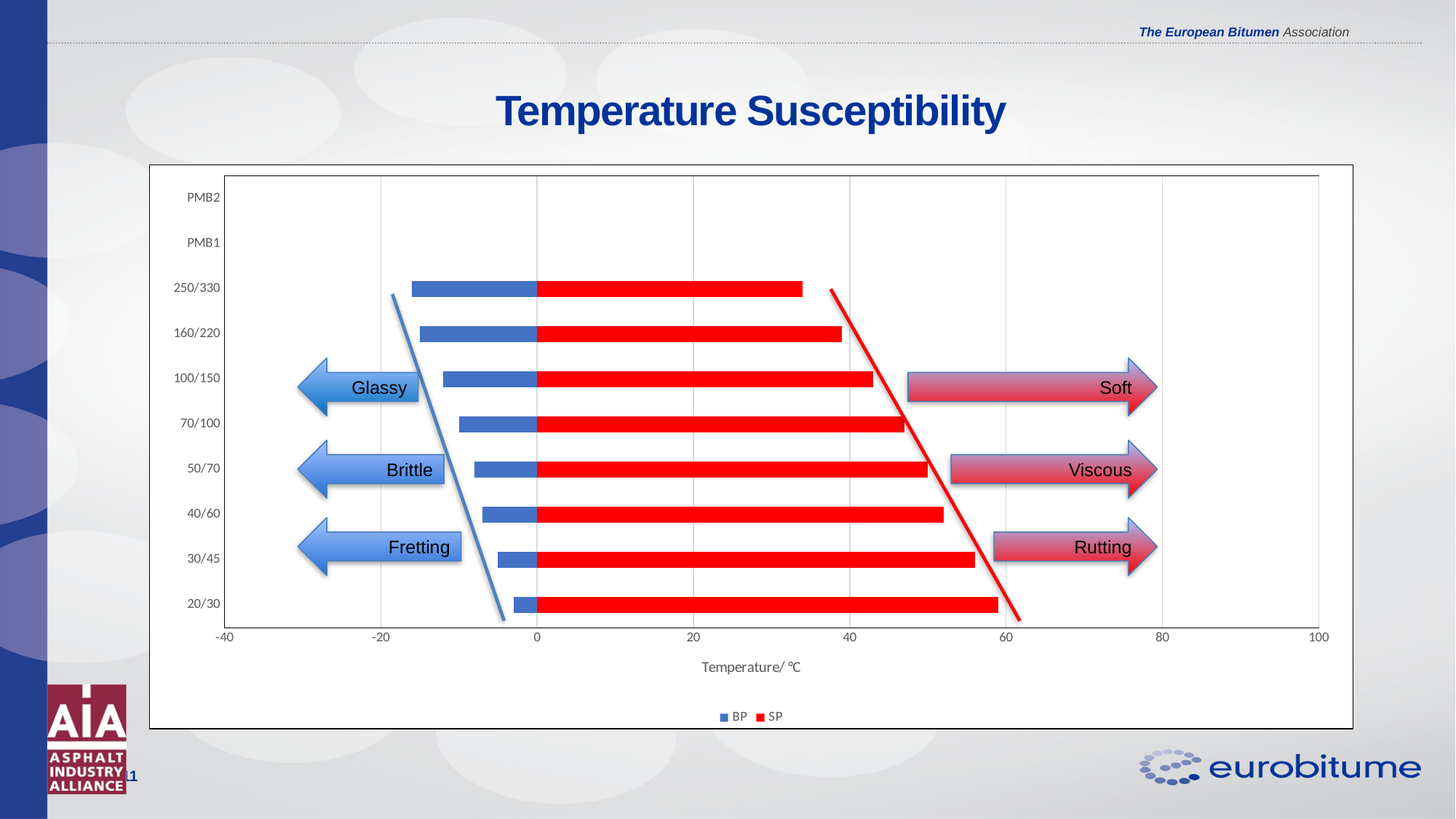
Is the BP value for 250/330 greater or less than 0? less What kind of chart is shown on the slide? bar chart Which category has the highest SP value? 20/30 What is the title of the horizontal axis? Temperature/ °C Which has the larger SP value, 20/30 or 250/330? 20/30 Is the SP value for 70/100 greater or less than 40? greater Is the SP value for 250/330 greater or less than 40? less How many series does the legend list? 2 What are the two series named in the legend? BP and SP Among the categories with plotted bars, which has the lowest SP value? 250/330 Do the SP values rise or fall going from 20/30 up to 250/330? fall How many categories are listed on the vertical axis? 10